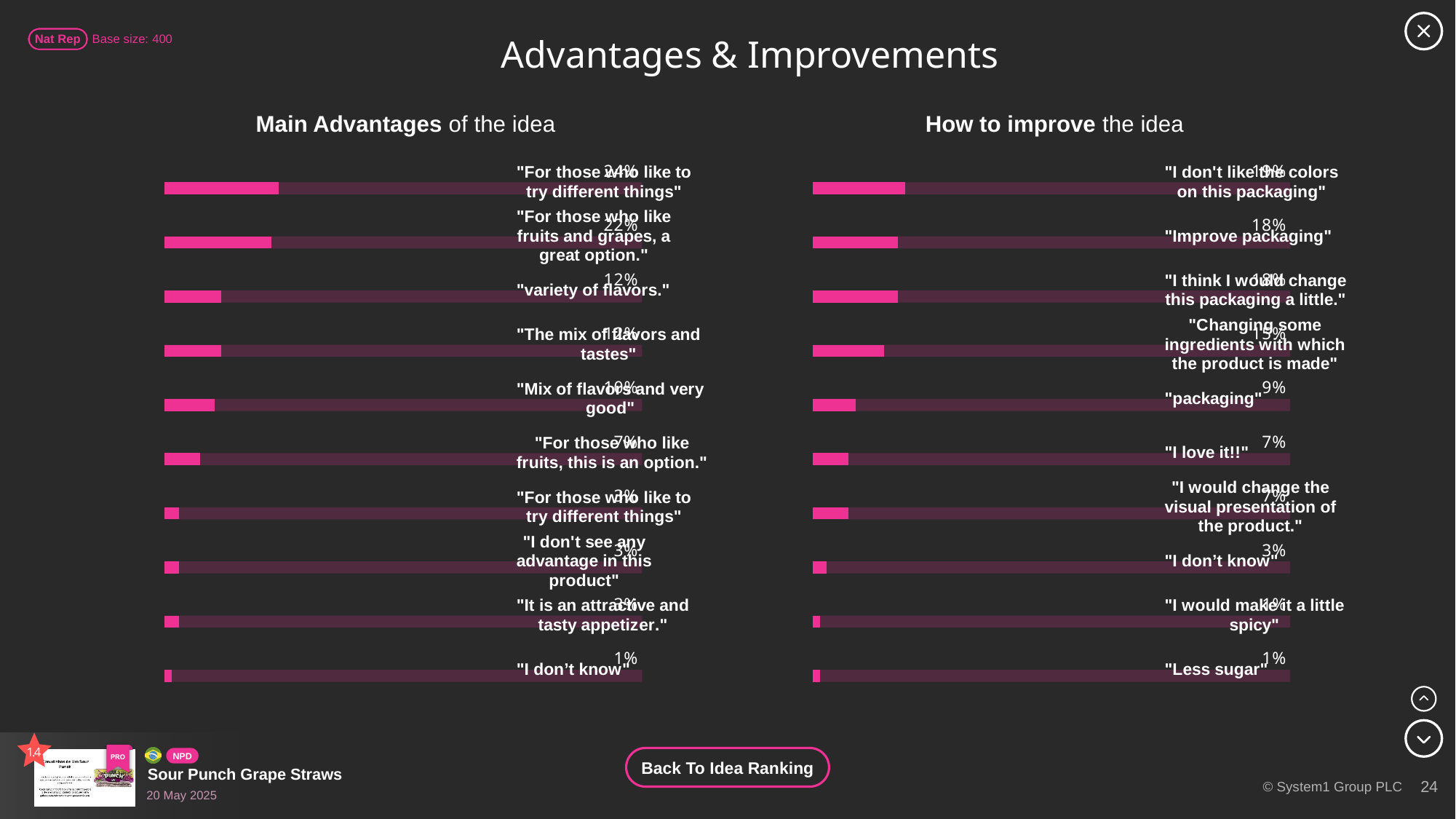
What kind of chart is used for 'Main Advantages of the idea'? Bar chart On the 'Main Advantages of the idea' chart, what percentage is shown for "For those who like fruits and grapes, a great option."? 22% On the 'How to improve the idea' chart, what percentage is shown for "Improve packaging"? 18% On the 'How to improve the idea' chart, what percentage is shown for "packaging"? 9% On the 'How to improve the idea' chart, which is larger: "Improve packaging" or "packaging"? "Improve packaging" On the 'How to improve the idea' chart, which response has the highest percentage? "I don't like the colors on this packaging" How many bars are shown on the 'How to improve the idea' chart? 10 On the 'How to improve the idea' chart, what percentage is shown for "Less sugar"? 1% On the 'Main Advantages of the idea' chart, what percentage is shown for "variety of flavors."? 12% On the 'Main Advantages of the idea' chart, what is the difference in percentage points between "For those who like fruits and grapes, a great option." and "variety of flavors."? 10 percentage points On the 'Main Advantages of the idea' chart, which response has the lowest percentage? "I don't know" On the 'Main Advantages of the idea' chart, what percentage is shown for "I don't know"? 1%